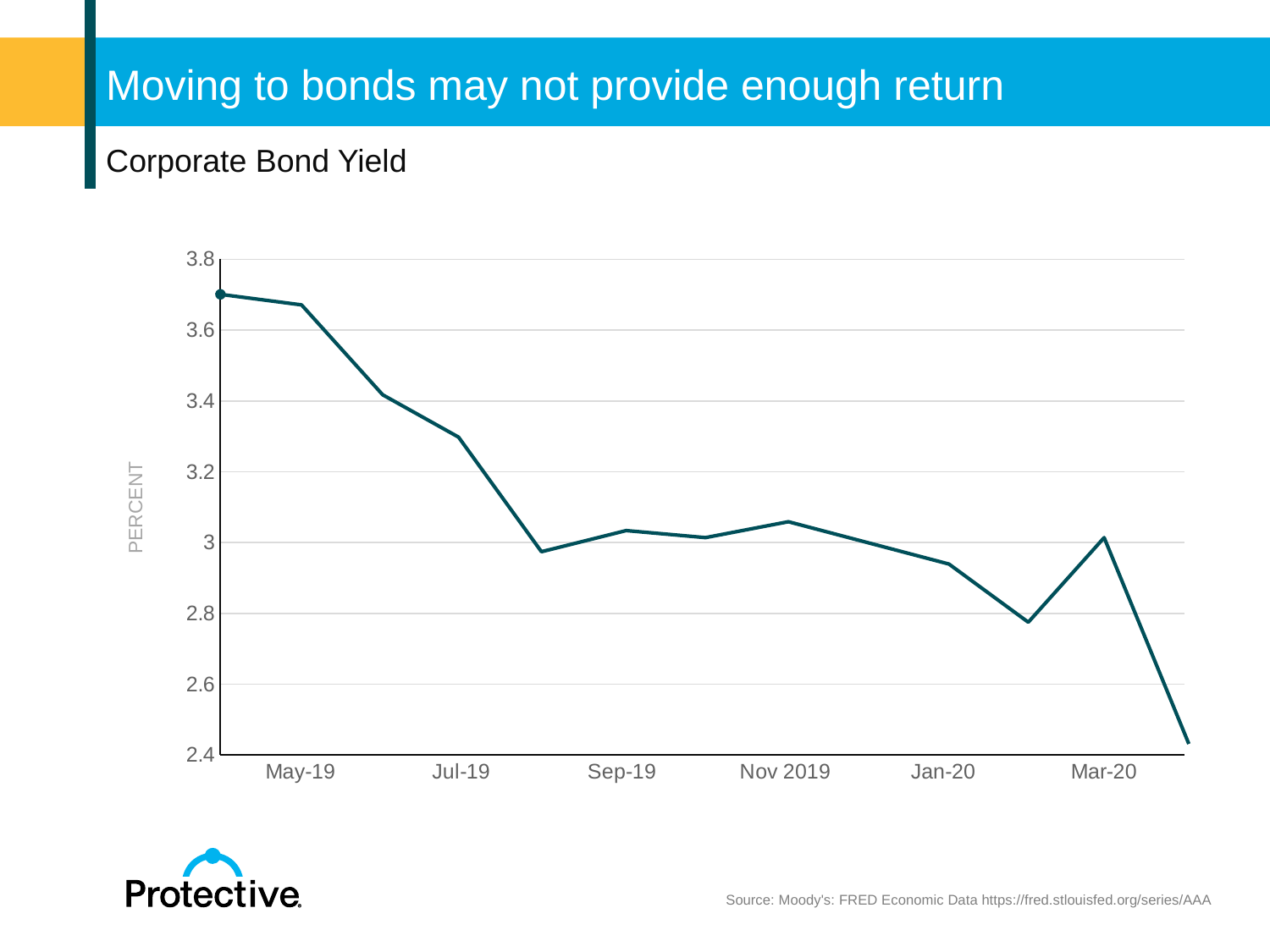
Is the value for Jan-20 greater or less than 3? less Is the value for May-19 greater or less than 3.6? greater How many month labels are shown along the x axis? 6 What is the label on the vertical axis of the chart? PERCENT Is the value for Jul-19 greater or less than 3.2? greater Overall, does the corporate bond yield rise or fall from left to right across the chart? fall Which is larger, the value for May-19 or the value for Mar-20? May-19 What is the title of the chart? Corporate Bond Yield What kind of chart is shown on the slide? line chart Among the labeled months on the x axis, which has the highest corporate bond yield? May-19